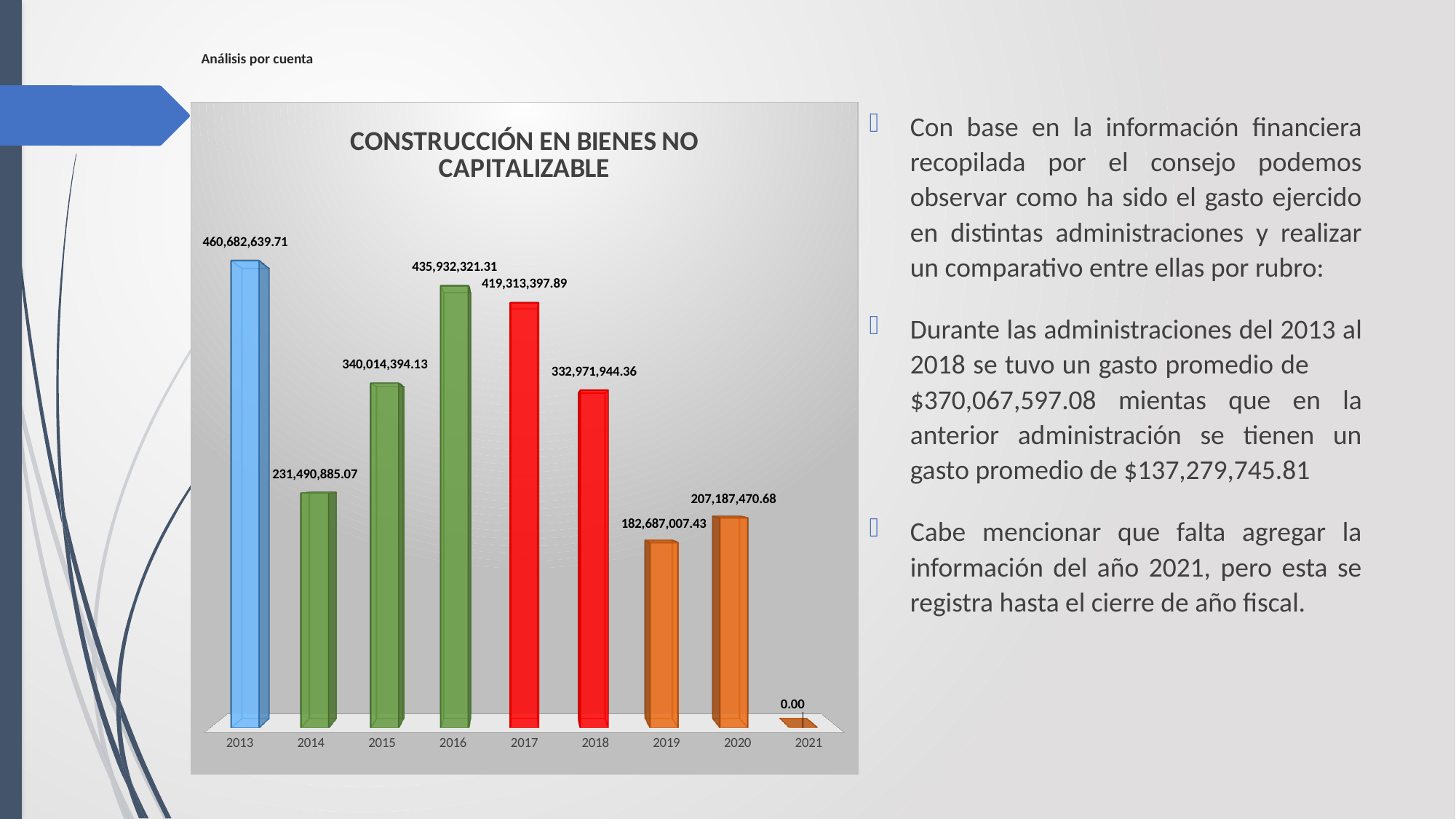
What kind of chart is shown on the slide? Bar chart What is the difference between the values for 2020 and 2019? 24,500,463.25 Which is larger, the value for 2015 or the value for 2018? 2015 What is the value for 2013 in the chart? 460,682,639.71 What is the title of the chart? CONSTRUCCIÓN EN BIENES NO CAPITALIZABLE Which year has the lowest value in the chart? 2021 How many years are shown on the x axis of the chart? 9 What is the value for 2019 in the chart? 182,687,007.43 What is the value for 2016 in the chart? 435,932,321.31 Which year has the highest value in the chart? 2013 What is the value for 2021 in the chart? 0.00 What is the difference between the values for 2013 and 2016? 24,750,318.40